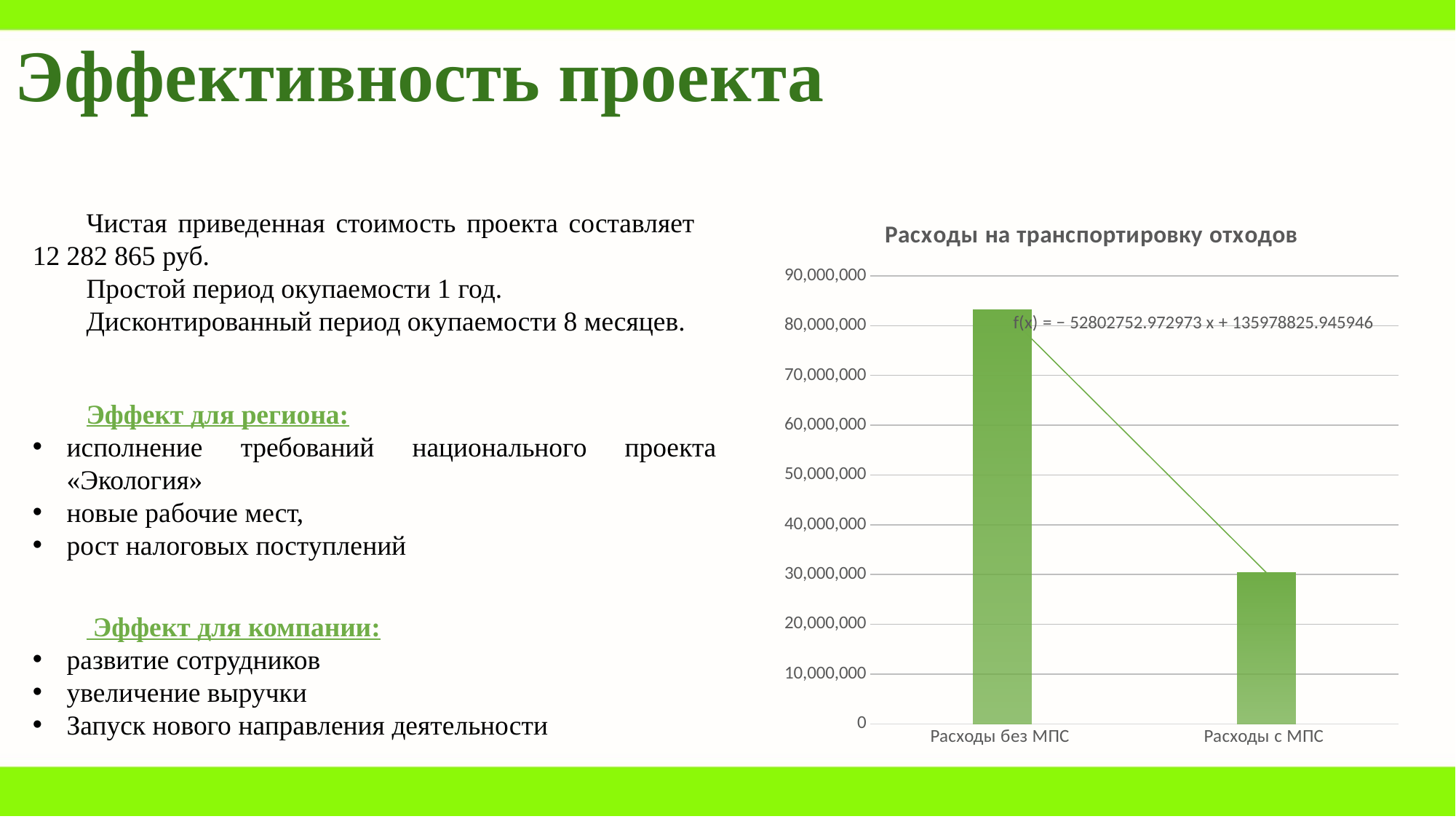
Is the value for Расходы с МПС greater or less than 20,000,000? greater Is the value for Расходы без МПС greater or less than 80,000,000? greater Which is larger, the value for Расходы без МПС or the value for Расходы с МПС? Расходы без МПС Which category has the highest value in the chart? Расходы без МПС Do the values rise or fall from Расходы без МПС to Расходы с МПС? fall What is the highest value shown on the vertical axis of the chart? 90,000,000 Which category has the lowest value in the chart? Расходы с МПС What kind of chart is shown on the slide? Bar chart What is the title of the chart? Расходы на транспортировку отходов How many categories are plotted in the chart? 2 Is the value for Расходы с МПС greater or less than 40,000,000? less